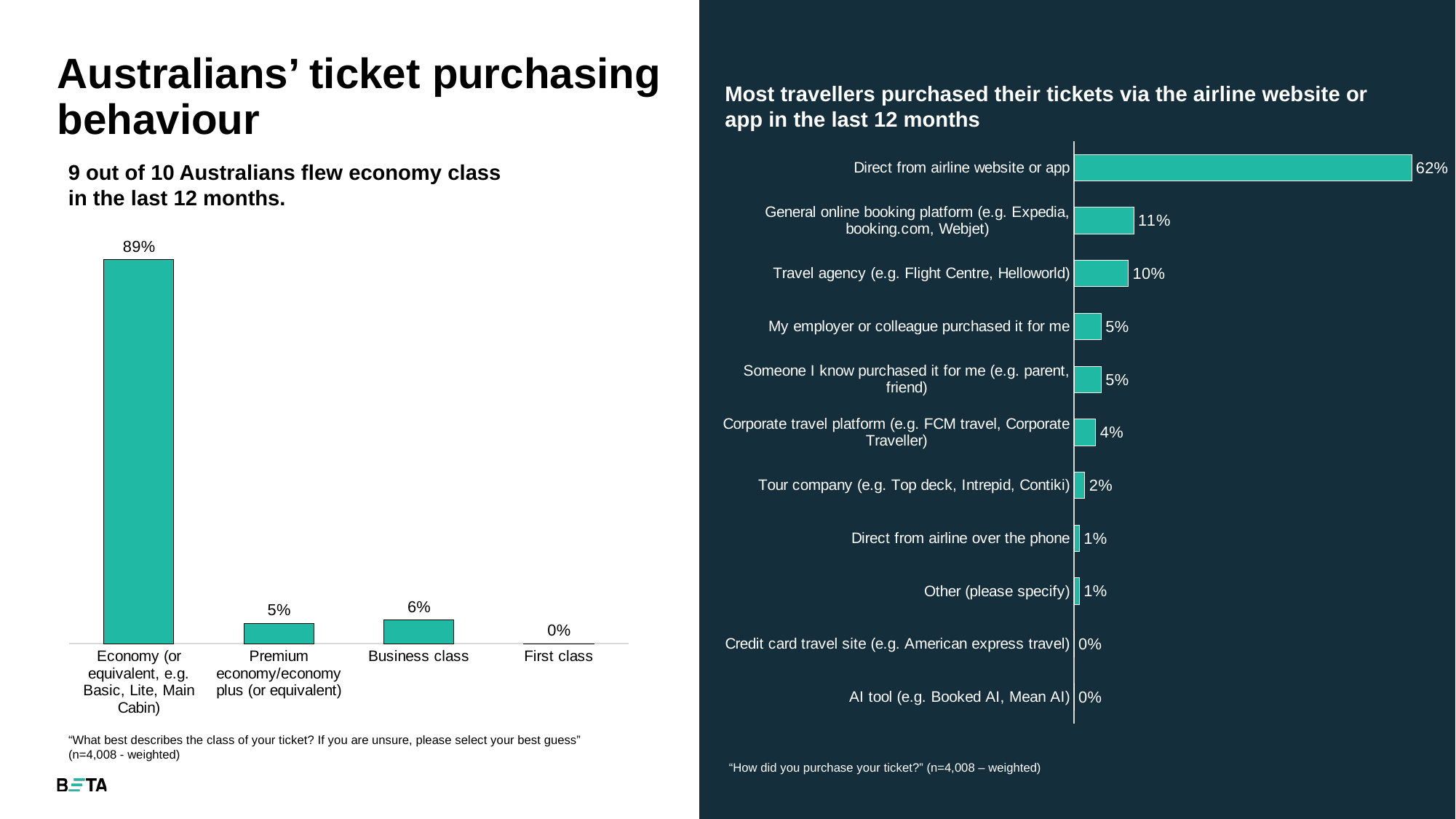
In the left chart on ticket class, what is the difference between Economy (or equivalent) and Business class? 83% What type of chart is the right chart on how tickets were purchased? Bar chart In the right chart on how tickets were purchased, what percentage purchased direct from the airline website or app? 62% In the right chart on how tickets were purchased, which purchase method has the highest value? Direct from airline website or app In the right chart on how tickets were purchased, what is the value for Travel agency (e.g. Flight Centre, Helloworld)? 10% In the left chart on ticket class, which category has the lowest value? First class In the left chart on ticket class, which is larger: Premium economy/economy plus or Business class? Business class In the right chart on how tickets were purchased, how many purchase methods are listed? 11 In the left chart on ticket class, how many ticket class categories are shown? 4 In the right chart on how tickets were purchased, what is the difference between General online booking platform and Travel agency? 1% In the left chart on ticket class, what is the value for Business class? 6% In the left chart on ticket class, what percentage of Australians flew Economy (or equivalent) in the last 12 months? 89%